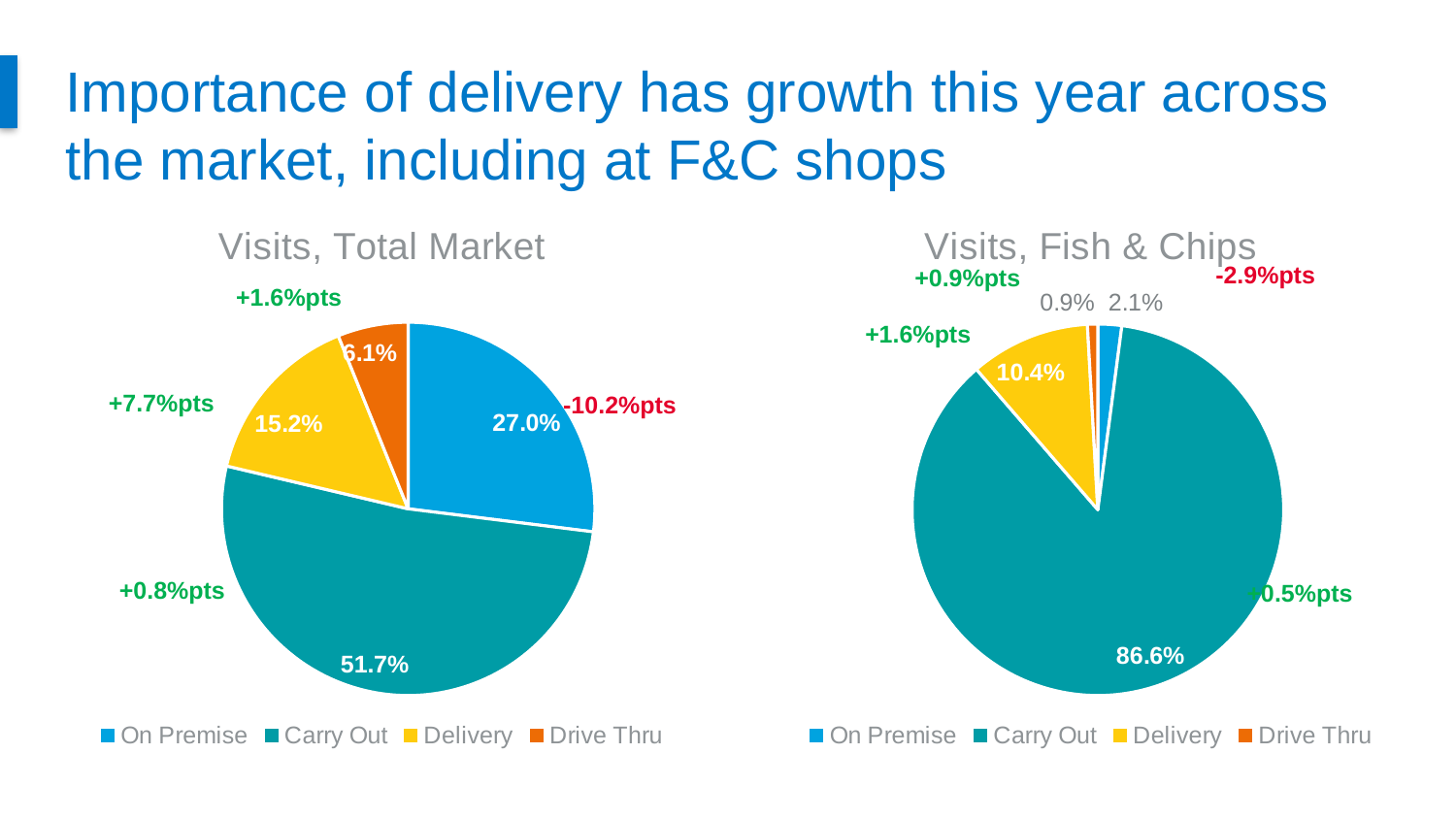
In the 'Visits, Total Market' chart, what share do Carry Out visits have? 51.7% In the 'Visits, Total Market' chart, what share do Delivery visits have? 15.2% In the 'Visits, Total Market' chart, what share do Drive Thru visits have? 6.1% What kind of chart is used on this slide? Pie chart In the 'Visits, Fish & Chips' chart, what share do Delivery visits have? 10.4% How many categories does the legend of the 'Visits, Fish & Chips' chart list? 4 In the 'Visits, Total Market' chart, which category has the smallest share? Drive Thru In the 'Visits, Total Market' chart, which category has the largest share? Carry Out In the 'Visits, Total Market' chart, how much larger is the Carry Out share than the On Premise share? 24.7% In the 'Visits, Total Market' chart, what share do On Premise visits have? 27.0% In the 'Visits, Fish & Chips' chart, what share do Carry Out visits have? 86.6% Is the Delivery share larger in the 'Visits, Total Market' chart or the 'Visits, Fish & Chips' chart? Visits, Total Market